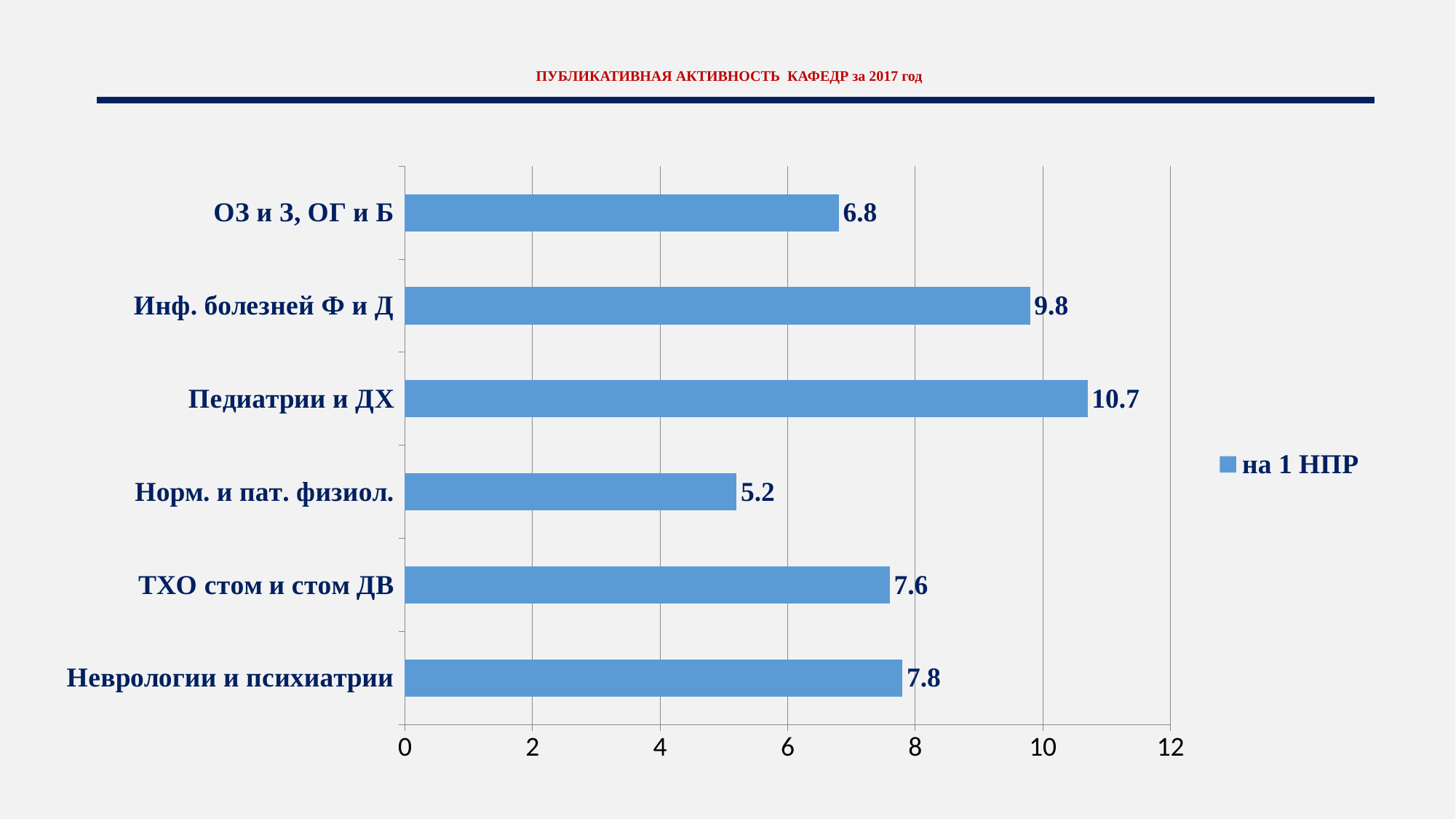
Which category has the lowest value? Норм. и пат. физиол. How many categories are shown in the chart? 6 What is the value for Педиатрии и ДХ? 10.7 Which is larger, the value for Неврологии и психиатрии or the value for ТХО стом и стом ДВ? Неврологии и психиатрии What is the value for Норм. и пат. физиол.? 5.2 What kind of chart is shown on the slide? bar chart What series name does the legend show? на 1 НПР Is the value for ОЗ и З, ОГ и Б greater or less than 8? less Which category has the highest value? Педиатрии и ДХ What is the difference between the values for Инф. болезней Ф и Д and ОЗ и З, ОГ и Б? 3 What is the difference between the values for Педиатрии и ДХ and Норм. и пат. физиол.? 5.5 What is the value for Инф. болезней Ф и Д? 9.8